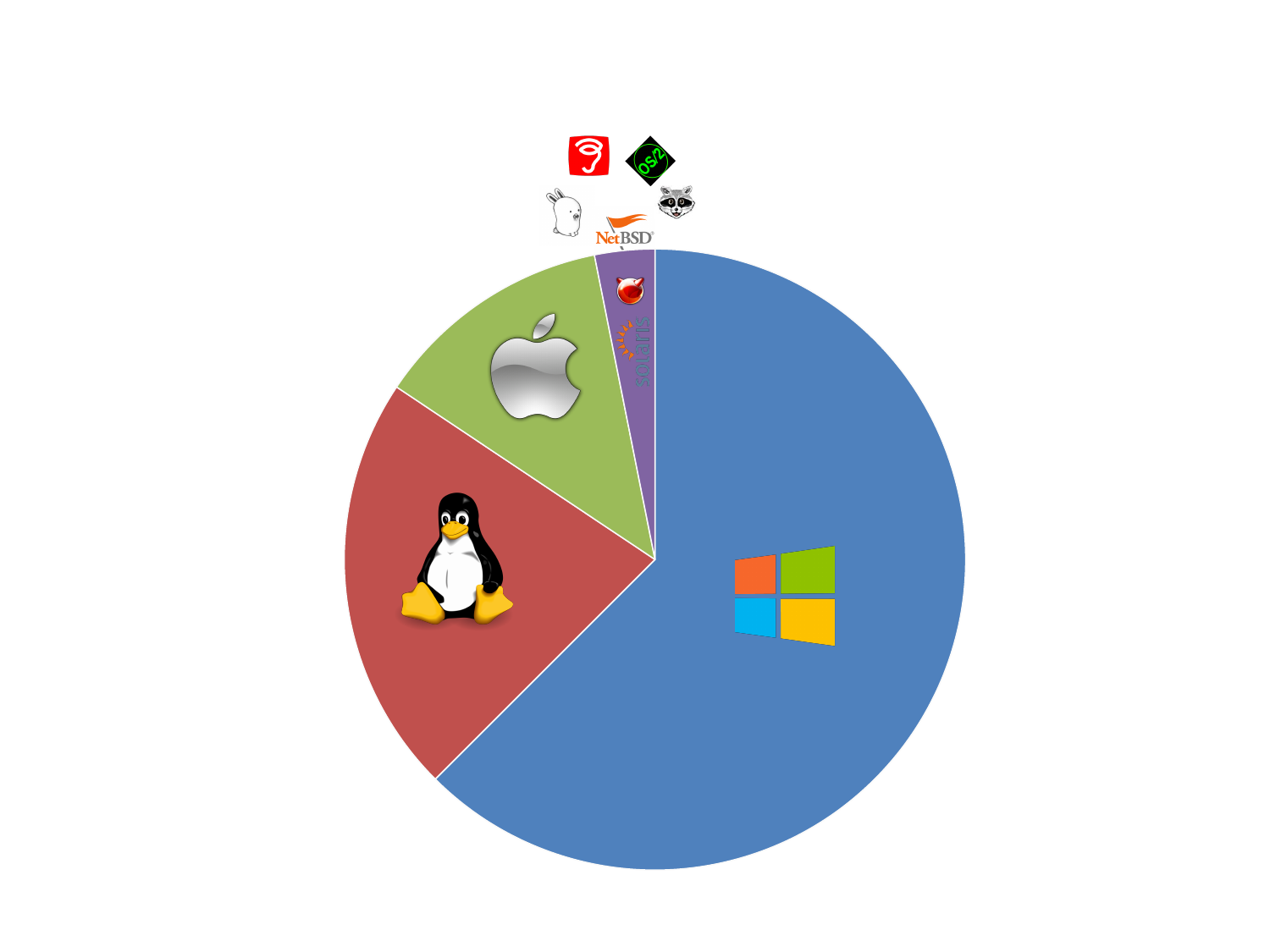
What colour is the slice containing the Windows logo? blue Which is larger, the slice with the Linux penguin logo or the slice with the Apple logo? the slice with the Linux penguin logo What kind of chart is shown on the slide? pie chart Which slice of the pie chart is the largest? the blue slice with the Windows logo Which is larger, the slice with the Windows logo or the slice with the Linux penguin logo? the slice with the Windows logo Which is larger, the slice with the Apple logo or the purple slice labelled Solaris? the slice with the Apple logo Does the slice with the Windows logo take up more or less than half of the pie? more What colour is the slice containing the Apple logo? green